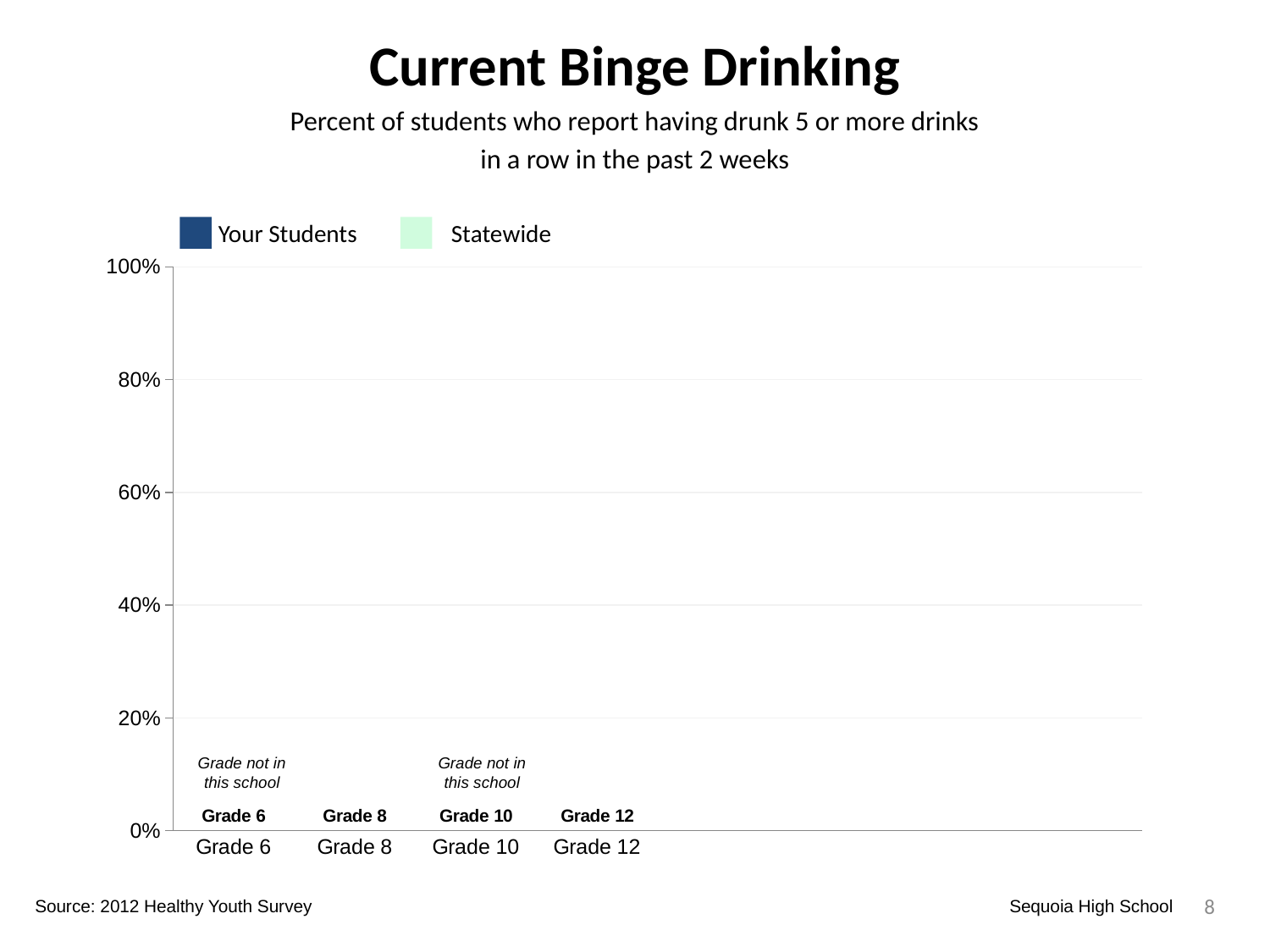
How many series does the chart's legend list? 2 What is the highest value shown on the chart's y axis? 100% How many grade categories are shown along the x axis of the chart? 4 What is the title of the chart? Current Binge Drinking Which grades are marked as 'Grade not in this school' on the chart? Grade 6 and Grade 10 Which two series are named in the chart's legend? Your Students and Statewide